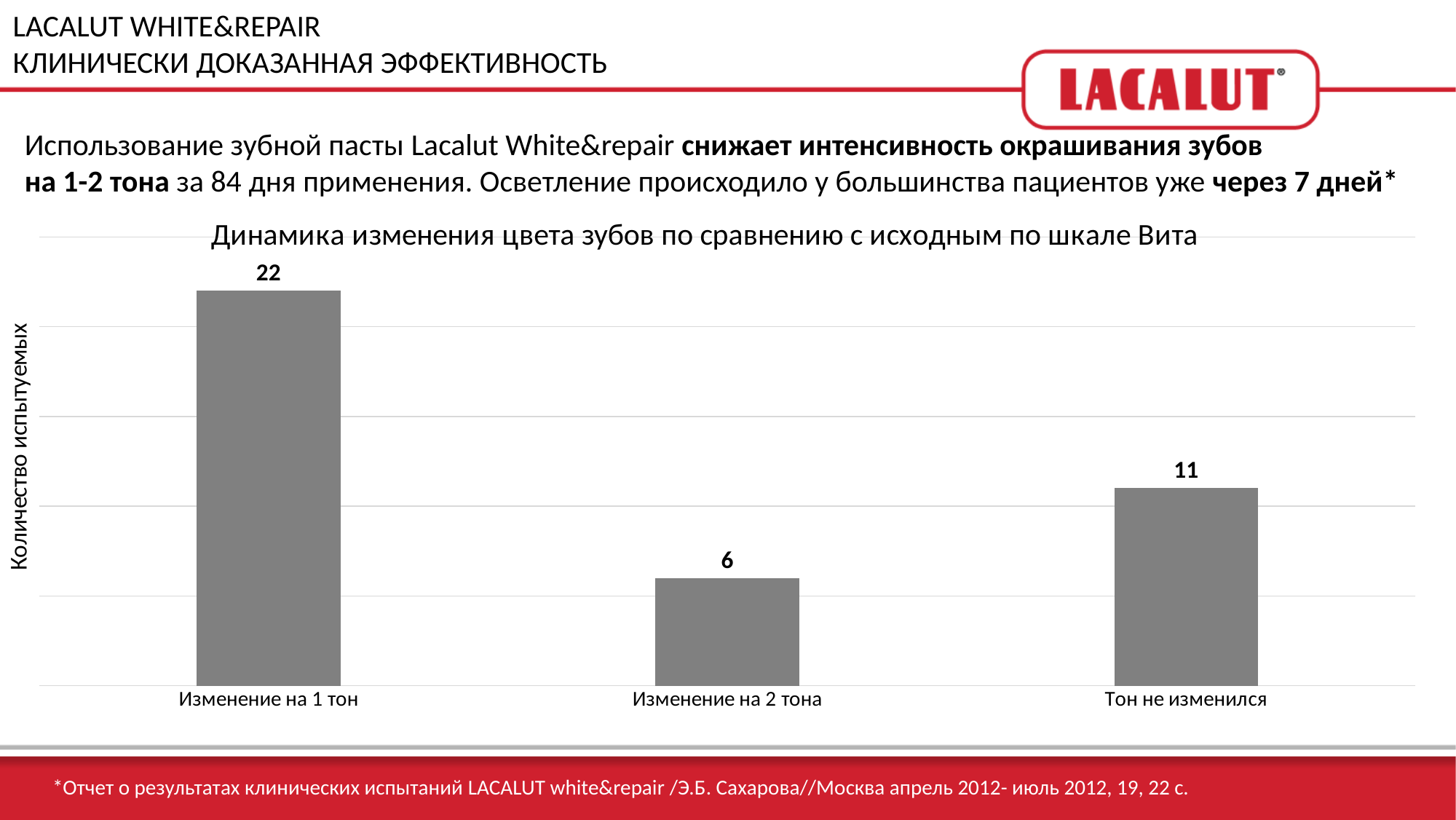
Which is larger: the value for "Тон не изменился" or the value for "Изменение на 2 тона"? Тон не изменился What kind of chart is shown on the slide? Bar chart What is the value for "Тон не изменился"? 11 What is the value for "Изменение на 2 тона"? 6 What is the difference between the values for "Изменение на 1 тон" and "Тон не изменился"? 11 Which category has the highest value? Изменение на 1 тон How many categories are shown in the chart? 3 What is the difference between the values for "Тон не изменился" and "Изменение на 2 тона"? 5 What is the value for "Изменение на 1 тон"? 22 Which category has the lowest value? Изменение на 2 тона What is the title of the chart? Динамика изменения цвета зубов по сравнению с исходным по шкале Вита What is the total of all three bars in the chart? 39